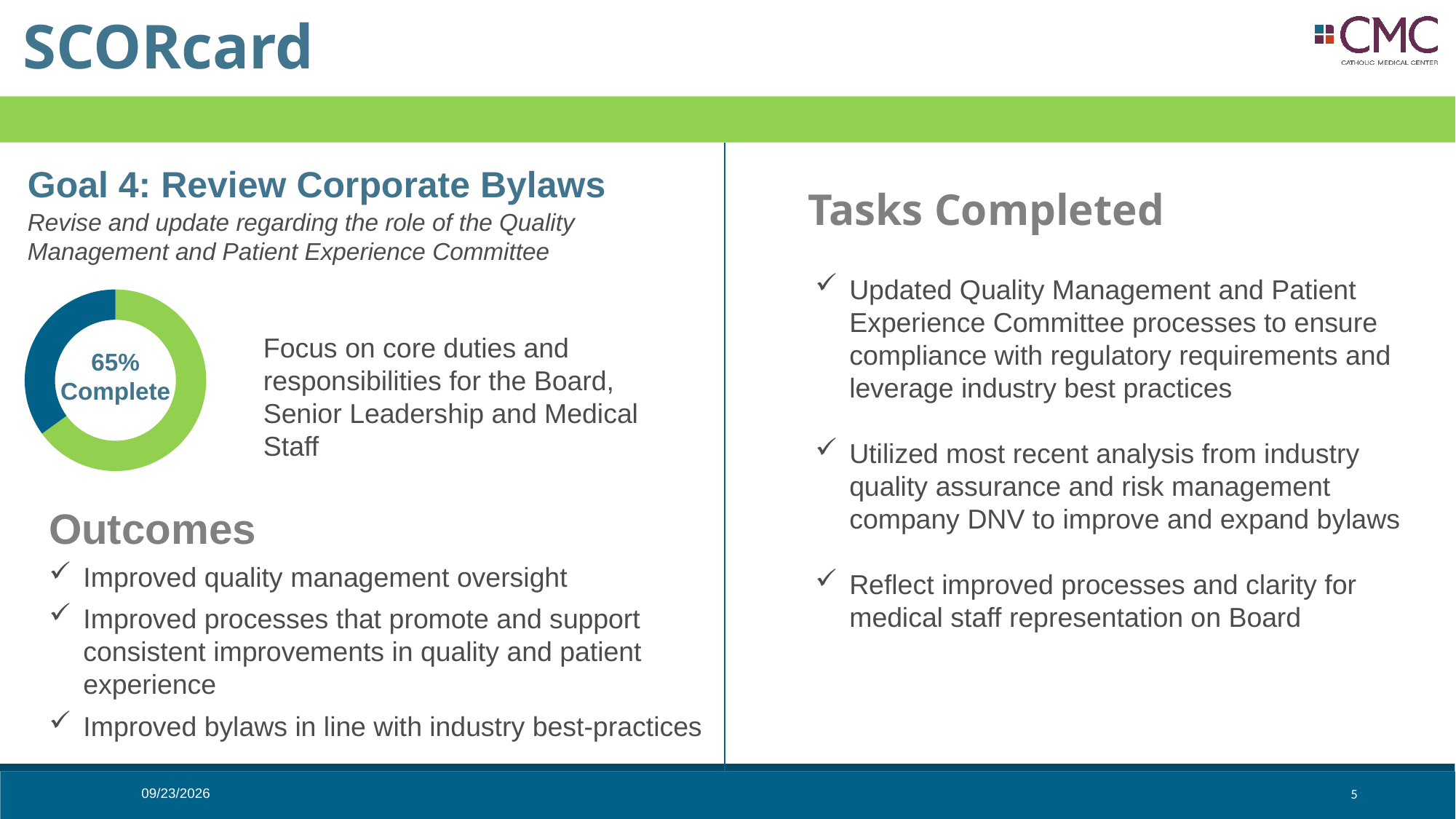
Which goal does the donut chart's completion percentage refer to? Goal 4: Review Corporate Bylaws What share of the donut chart does the green (complete) segment represent? 65% What text is printed in the centre of the donut chart? 65% Complete Which segment of the donut chart is larger, the green one or the dark blue one? Green Is the completed share shown in the donut chart greater or less than 50%? greater What kind of chart is shown on the slide? Donut chart What colour is the completed portion of the donut chart? Green What percentage complete does the donut chart show for Goal 4? 65% Is the dark blue (remaining) segment of the donut chart greater or less than 50%? less How many segments does the donut chart have? 2